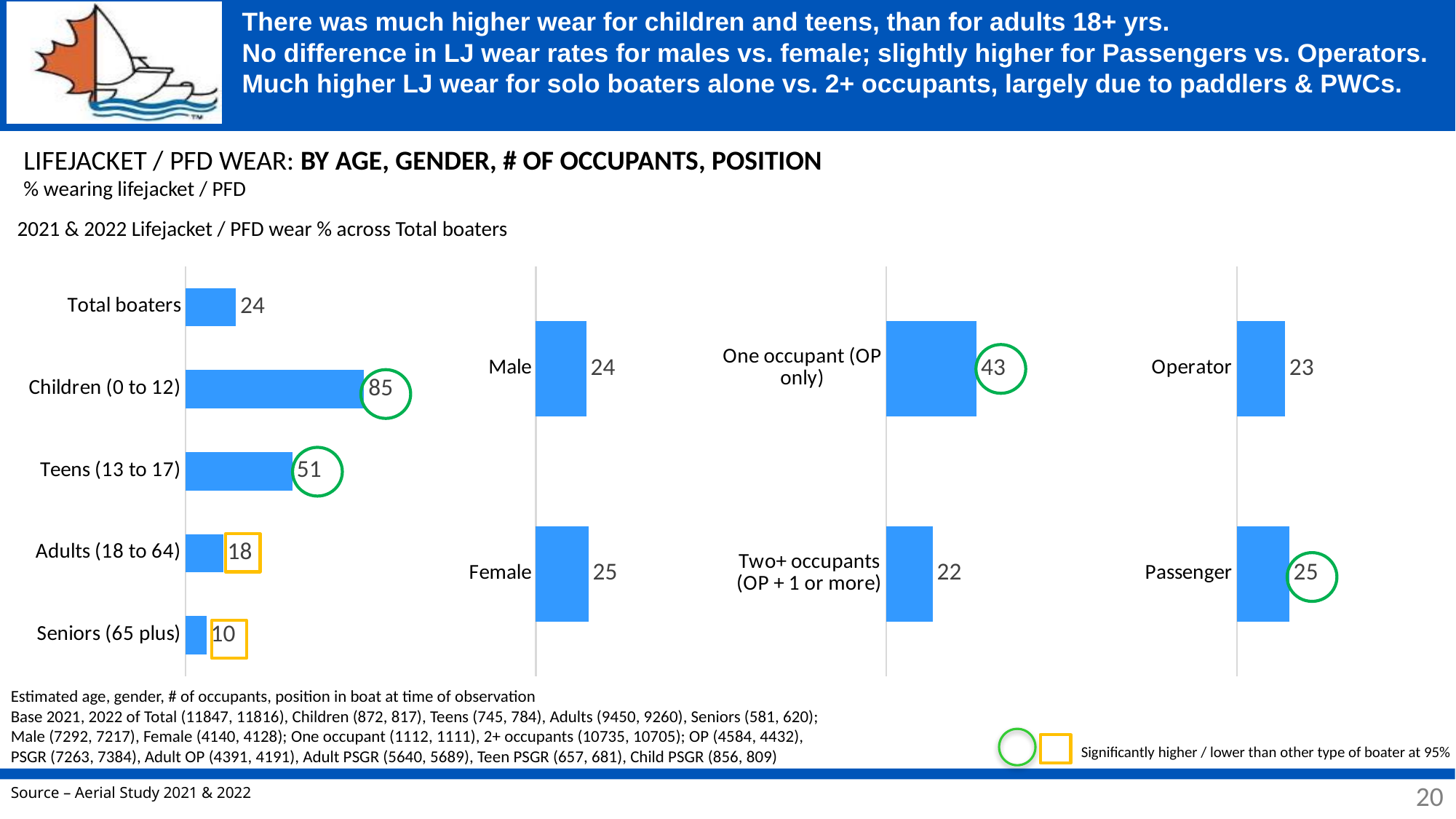
In the rightmost chart (by position), which is larger, Operator or Passenger? Passenger In the second chart from the left (by gender), what is the value for Female? 25 In the leftmost chart (by age), what is the difference between the values for Children (0 to 12) and Teens (13 to 17)? 34 In the second chart from the left (by gender), which is larger, Male or Female? Female In the leftmost chart (by age), which category has the lowest value? Seniors (65 plus) In the leftmost chart (by age), what is the lifejacket wear % for Children (0 to 12)? 85 What type of chart is used on this slide? Bar chart In the third chart from the left (by # of occupants), what is the value for One occupant (OP only)? 43 In the leftmost chart (by age), how many categories are plotted? 5 In the third chart from the left (by # of occupants), what is the difference between One occupant (OP only) and Two+ occupants (OP + 1 or more)? 21 In the leftmost chart (by age), which category has the highest value? Children (0 to 12) In the rightmost chart (by position), what is the value for Operator? 23